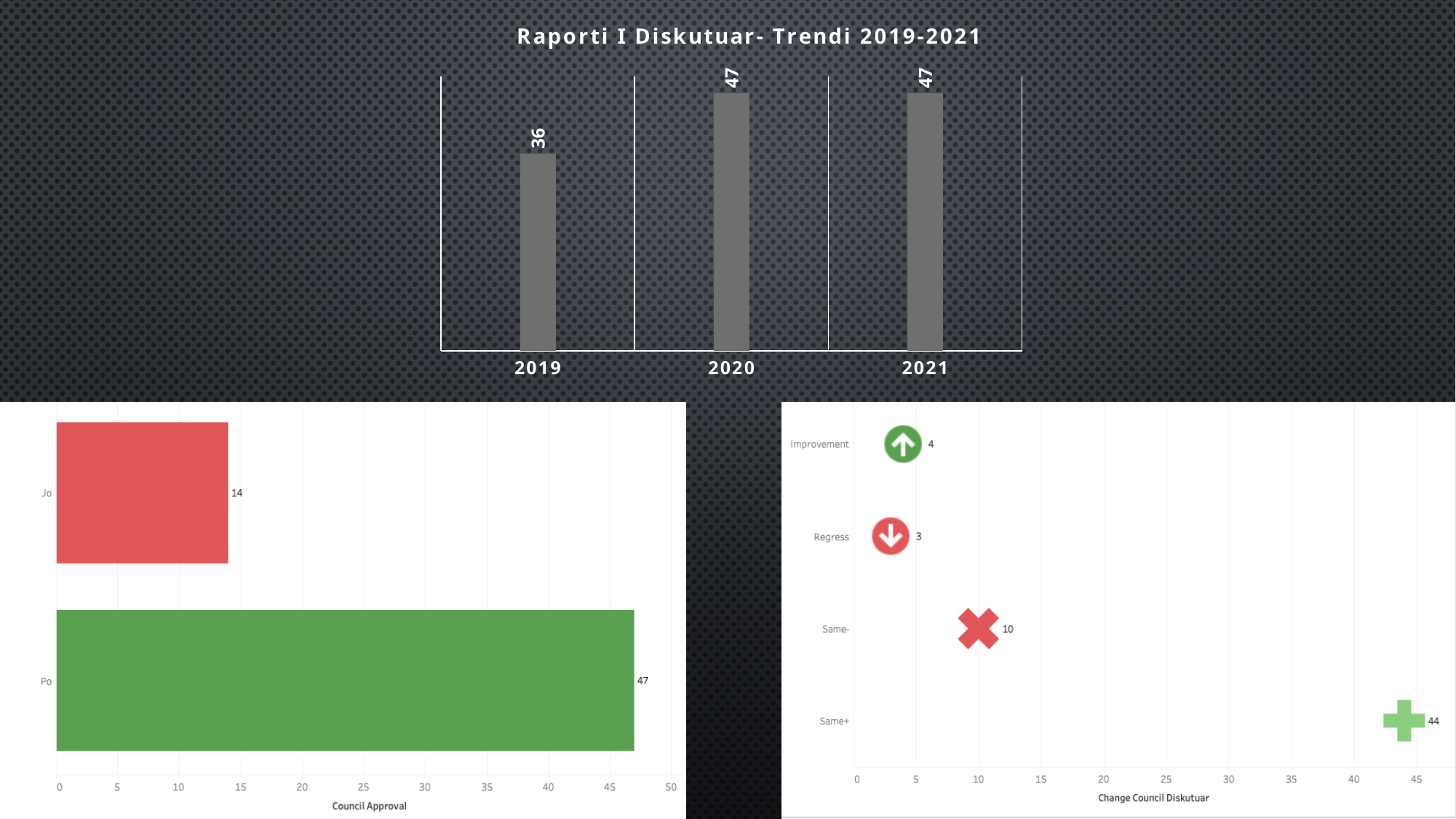
In the chart titled 'Raporti I Diskutuar- Trendi 2019-2021', how many years are shown? 3 In the bottom-left 'Council Approval' chart, what is the difference between Po and Jo? 33 What kind of chart is the top chart titled 'Raporti I Diskutuar- Trendi 2019-2021'? bar chart In the bottom-right 'Change Council Diskutuar' chart, what is the value for Same+? 44 In the chart titled 'Raporti I Diskutuar- Trendi 2019-2021', which year has the lowest value? 2019 In the chart titled 'Raporti I Diskutuar- Trendi 2019-2021', what is the value for 2019? 36 In the bottom-right 'Change Council Diskutuar' chart, which is larger, Improvement or Same-? Same- In the chart titled 'Raporti I Diskutuar- Trendi 2019-2021', what is the value for 2020? 47 In the bottom-left 'Council Approval' chart, what is the value for Jo? 14 In the chart titled 'Raporti I Diskutuar- Trendi 2019-2021', what is the difference between the 2020 value and the 2019 value? 11 In the bottom-right 'Change Council Diskutuar' chart, which category has the lowest value? Regress In the bottom-left 'Council Approval' chart, what is the value for Po? 47